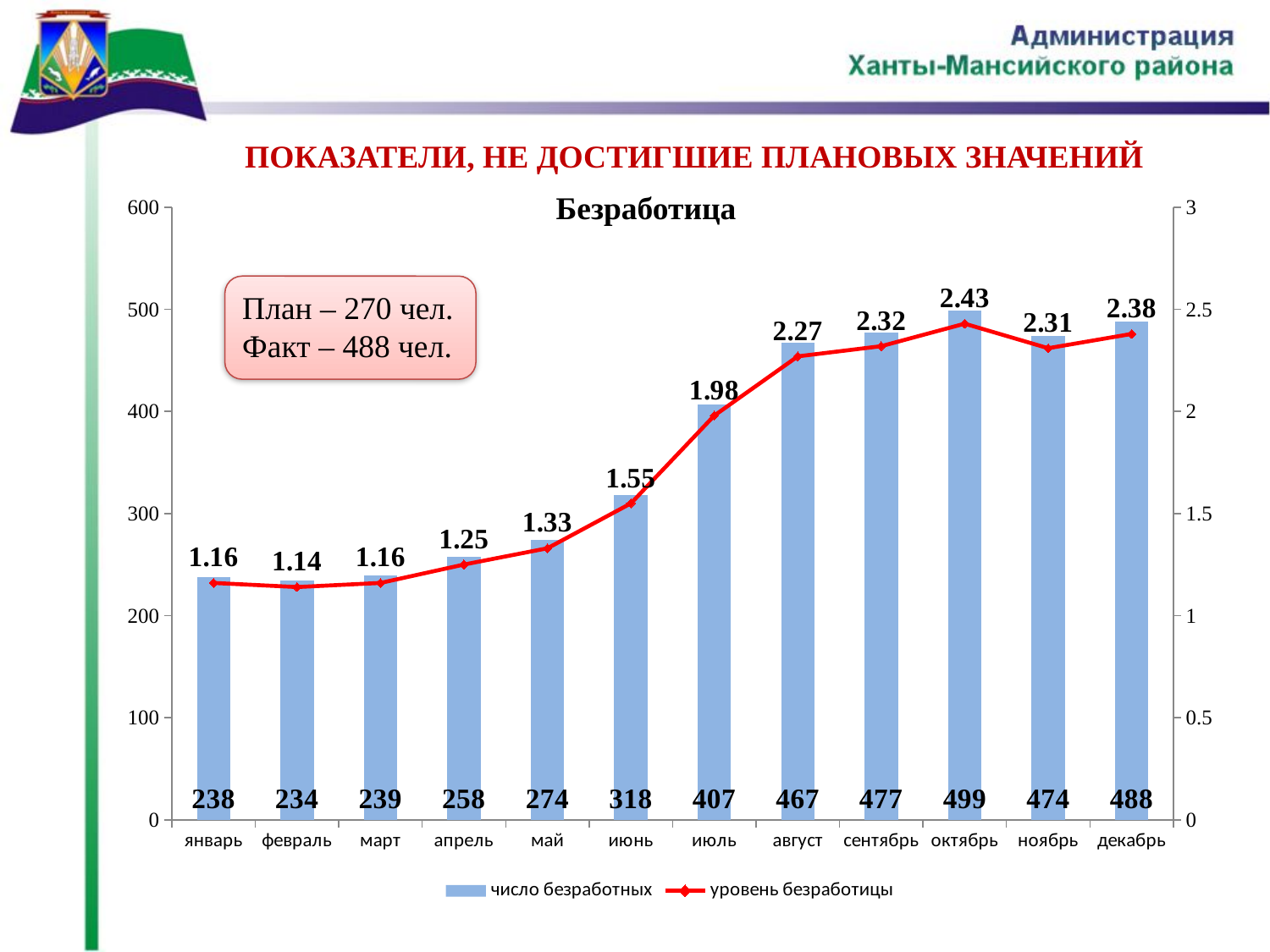
Which month has the highest number of unemployed? октябрь Which is larger, the number of unemployed in сентябрь or in ноябрь? сентябрь How many months are shown on the x axis? 12 What is the title of the chart? Безработица What is the unemployment rate (уровень безработицы) in июль? 1.98 Does the number of unemployed rise or fall from январь to октябрь? rise What kind of chart is used for the series число безработных? bar chart How many series does the legend list? 2 What is the difference between the number of unemployed in декабрь and in январь? 250 What is the number of unemployed (число безработных) in октябрь? 499 Which month has the lowest unemployment rate (уровень безработицы)? февраль Is the number of unemployed in июнь greater or less than 300? greater